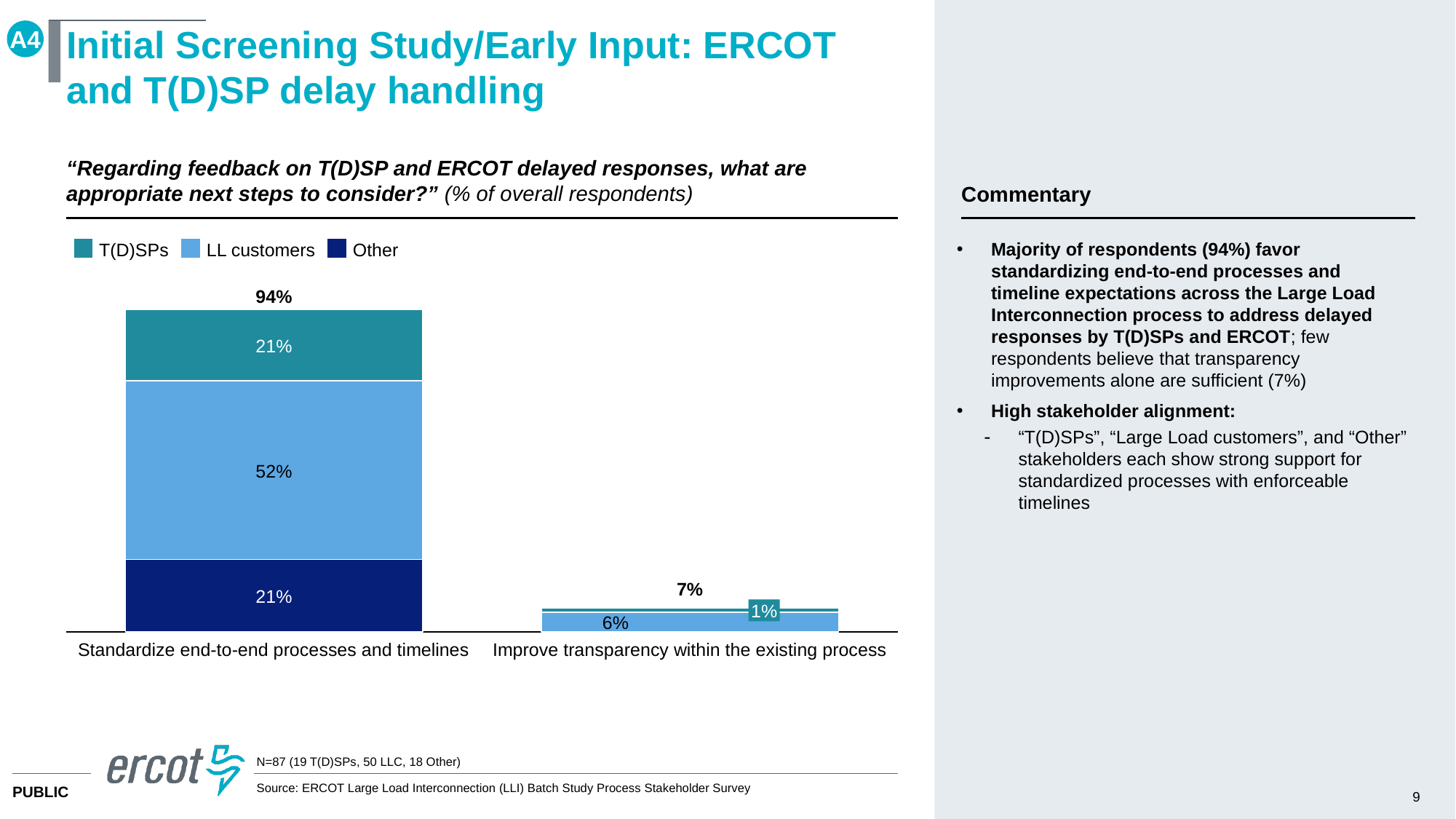
What is the T(D)SPs value for 'Standardize end-to-end processes and timelines'? 21% How many series does the legend list? 3 How many categories are shown on the x axis? 2 Which series is shown in the darkest blue colour in the legend? Other Which category has the highest total? Standardize end-to-end processes and timelines What is the LL customers value for 'Standardize end-to-end processes and timelines'? 52% What is the LL customers value for 'Improve transparency within the existing process'? 6% What is the total for the 'Improve transparency within the existing process' bar? 7% What type of chart is shown on the slide? Stacked bar chart What is the difference between the totals of the two bars? 87 percentage points What is the total for the 'Standardize end-to-end processes and timelines' bar? 94% What is the T(D)SPs value for 'Improve transparency within the existing process'? 1%